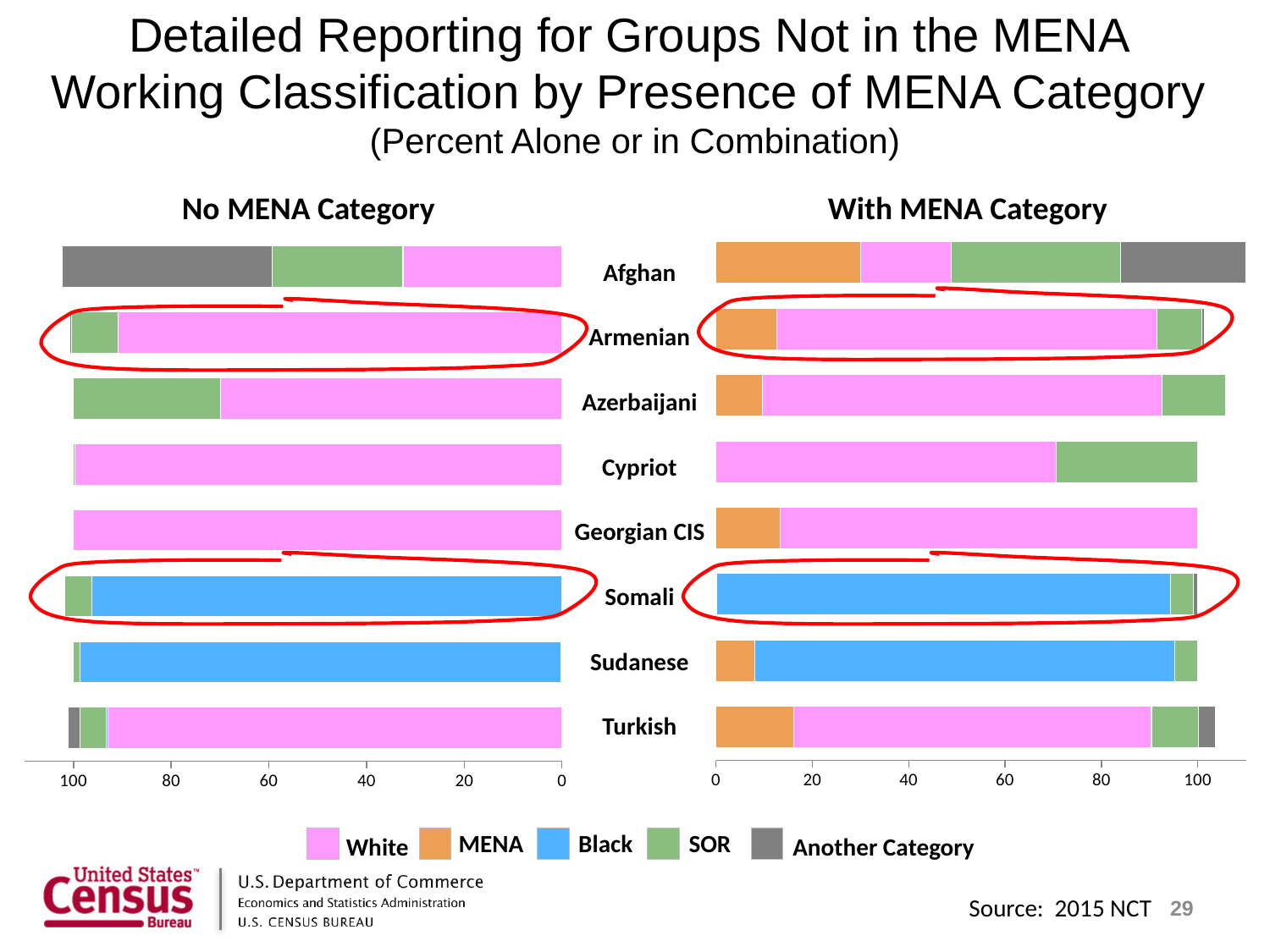
How many groups are listed on the "With MENA Category" chart? 8 How many series does the legend list? 5 In the "No MENA Category" chart, which is larger for Azerbaijani, the White segment or the SOR segment? White What kind of chart is the "No MENA Category" chart? Stacked bar chart What colour represents Black in the legend? Blue In the "No MENA Category" chart, is the White value for Cypriot greater or less than 80? greater In the "With MENA Category" chart, is the MENA value for Turkish greater or less than 20? less In the "With MENA Category" chart, which group has the largest MENA segment? Afghan In the "With MENA Category" chart, is the Black value for Somali greater or less than 80? greater Which two groups are circled in red on the slide? Armenian and Somali In the "No MENA Category" chart, which is larger for Somali, the Black segment or the SOR segment? Black